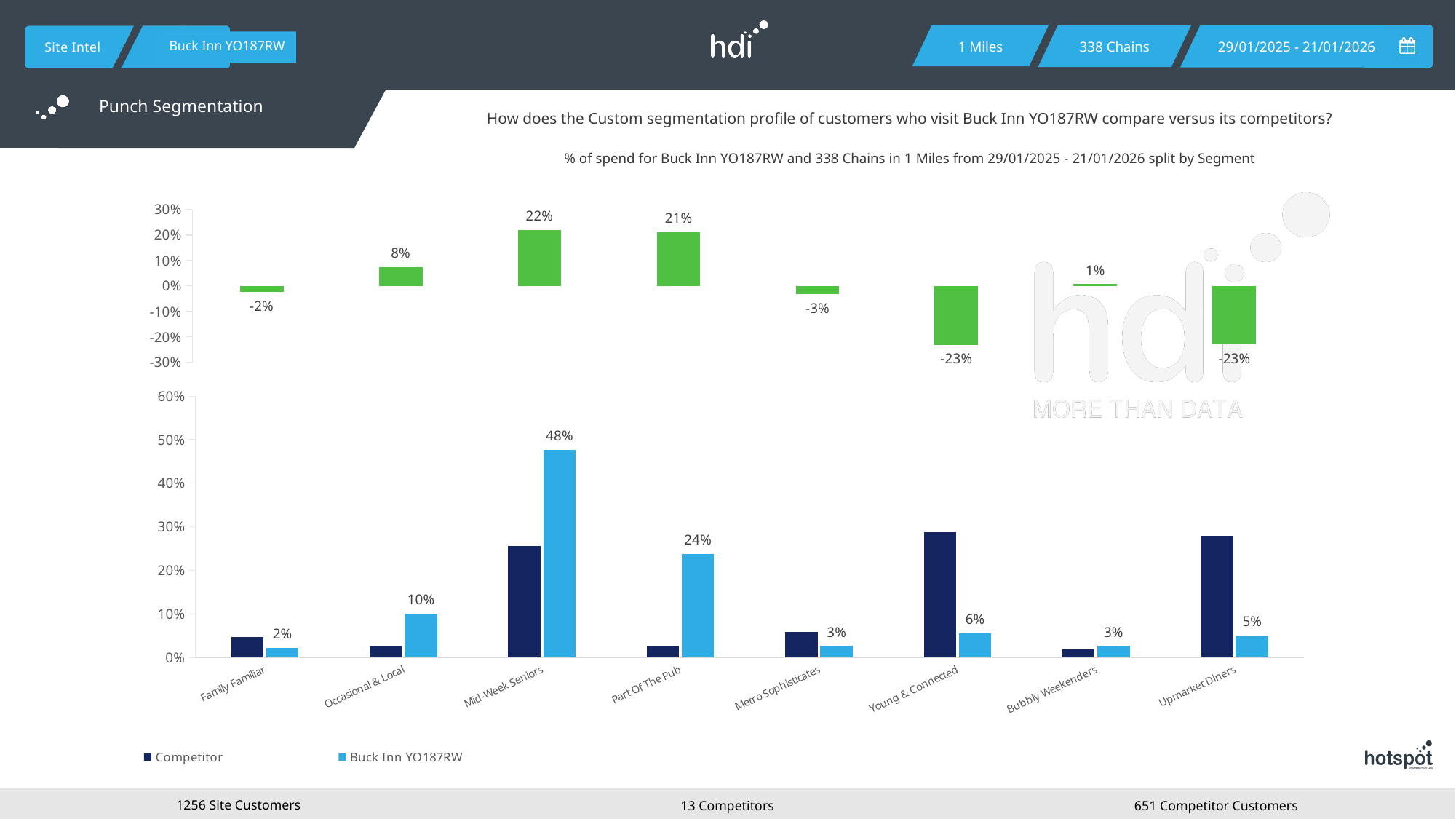
In the bottom chart, what is the value for Buck Inn YO187RW in the Mid-Week Seniors segment? 48% In the bottom chart, is the Competitor value for Mid-Week Seniors greater or less than 30%? less In the bottom chart, which segment has the lowest Buck Inn YO187RW value? Family Familiar In the bottom chart, what is the value for Buck Inn YO187RW in the Occasional & Local segment? 10% In the bottom chart, which segment has the highest Buck Inn YO187RW value? Mid-Week Seniors In the bottom chart, what is the difference between the Buck Inn YO187RW values for Mid-Week Seniors and Part Of The Pub? 24% In the top chart, which segment has the highest value? Mid-Week Seniors How many segments are shown on the x axis of the bottom chart? 8 In the bottom chart, is the Competitor value for Young & Connected greater or less than 20%? greater How many series does the legend of the bottom chart list? 2 In the bottom chart, for Young & Connected, which series has the larger value: Competitor or Buck Inn YO187RW? Competitor In the top chart, what is the value shown for Young & Connected? -23%